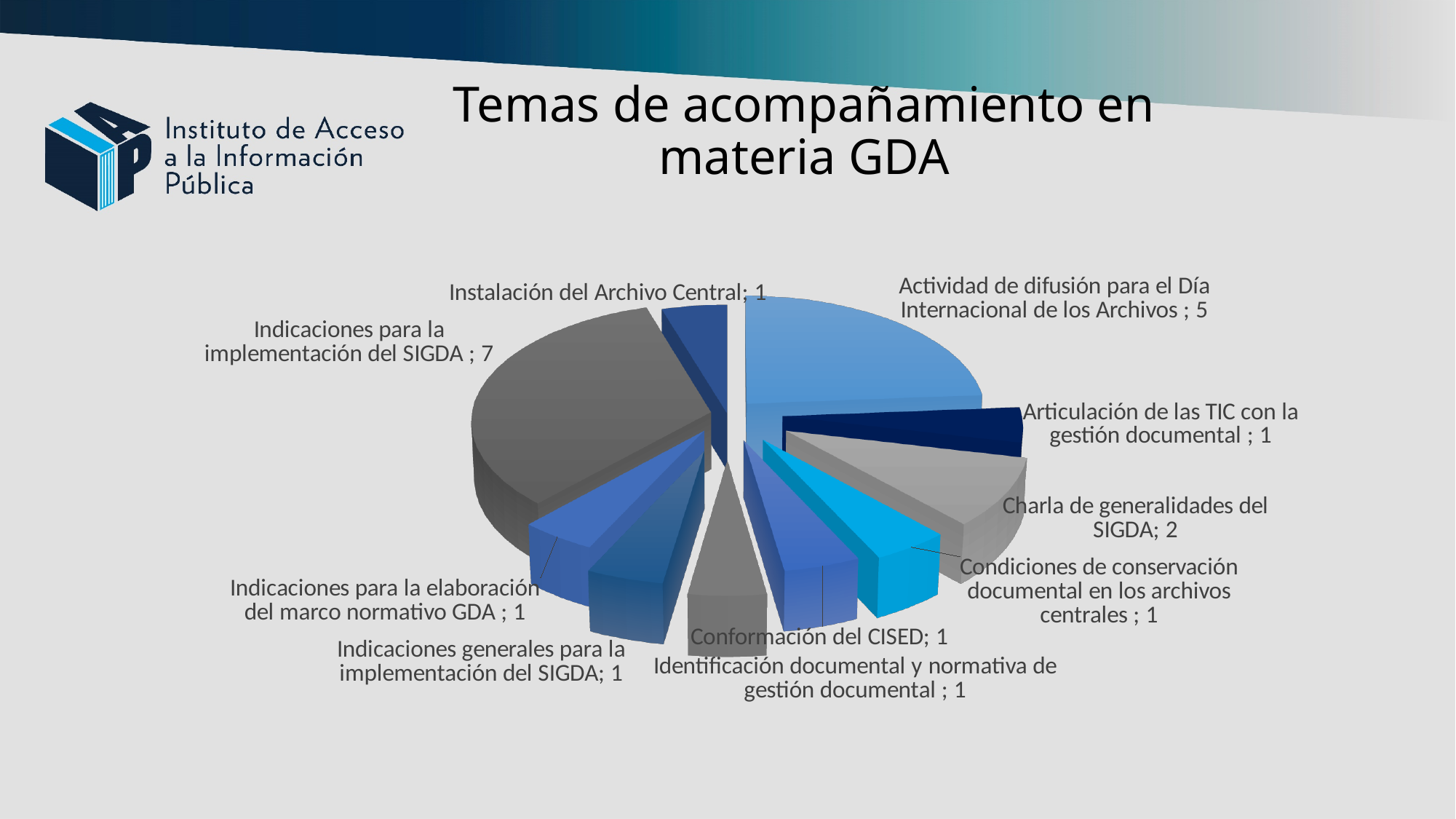
What is the value for 'Actividad de difusión para el Día Internacional de los Archivos'? 5 What is the total of all the values shown in the pie chart? 21 What is the difference between the values for 'Indicaciones para la implementación del SIGDA' and 'Actividad de difusión para el Día Internacional de los Archivos'? 2 What is the title of the chart on the slide? Temas de acompañamiento en materia GDA Which category has the highest value in the pie chart? Indicaciones para la implementación del SIGDA How many categories (slices) does the pie chart have? 10 What is the value for 'Charla de generalidades del SIGDA'? 2 What is the value for 'Indicaciones para la implementación del SIGDA'? 7 What is the value for 'Conformación del CISED'? 1 Which is larger: the value for 'Charla de generalidades del SIGDA' or the value for 'Articulación de las TIC con la gestión documental'? Charla de generalidades del SIGDA What kind of chart is shown on the slide? Pie chart How many categories in the pie chart have a value of 1? 7